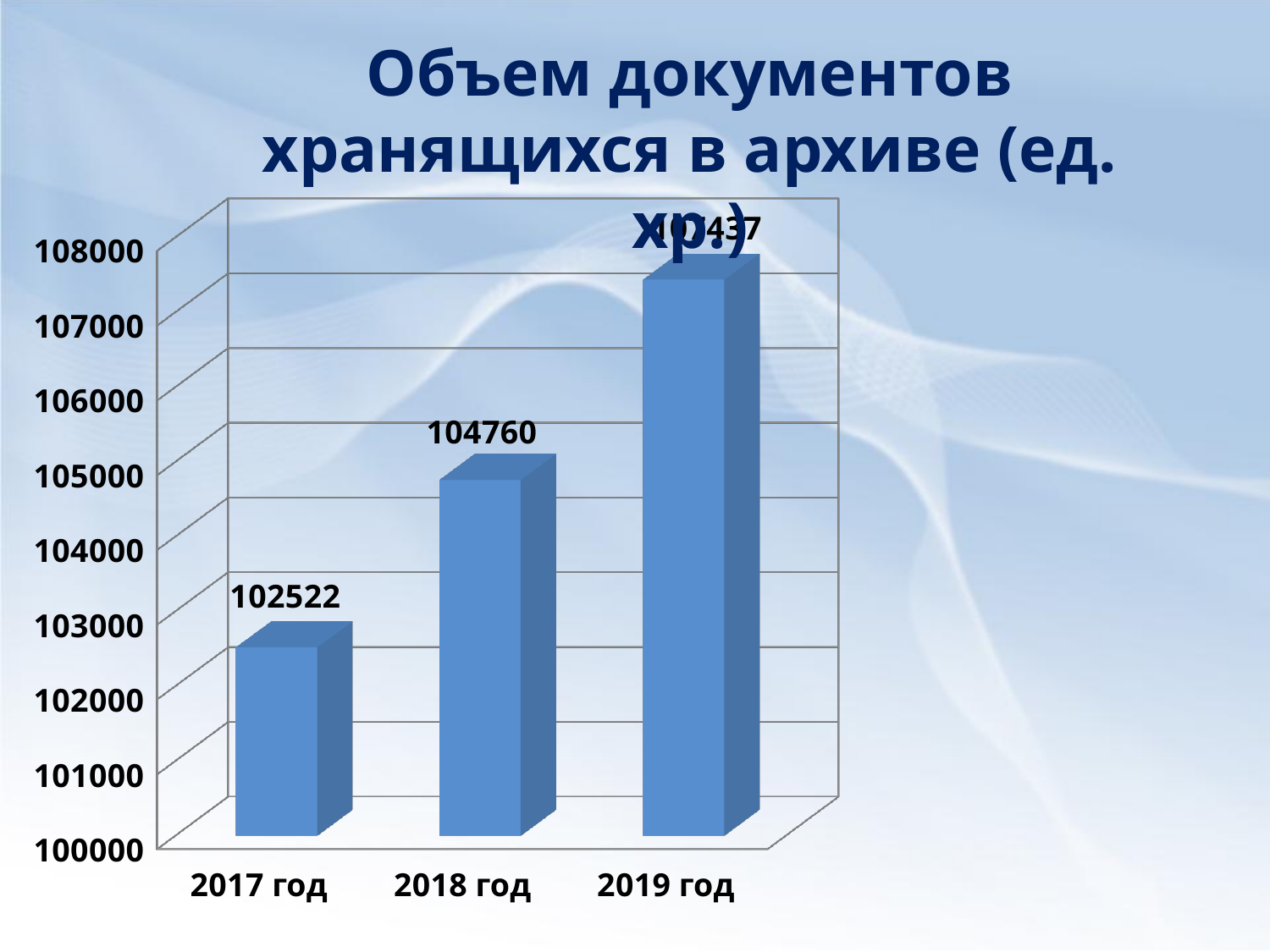
What kind of chart is shown on the slide? bar chart Which is larger, the value for 2018 год or the value for 2017 год? 2018 год How many years are shown on the chart? 3 Which year has the lowest value? 2017 год What is the difference between the values for 2018 год and 2017 год? 2238 What is the value for 2017 год? 102522 Is the value for 2019 год greater or less than 107000? greater What is the lowest value shown on the vertical axis? 100000 Is the value for 2017 год greater or less than 103000? less Which year has the highest value? 2019 год What is the value for 2018 год? 104760 Do the values rise or fall from 2017 год to 2019 год? rise